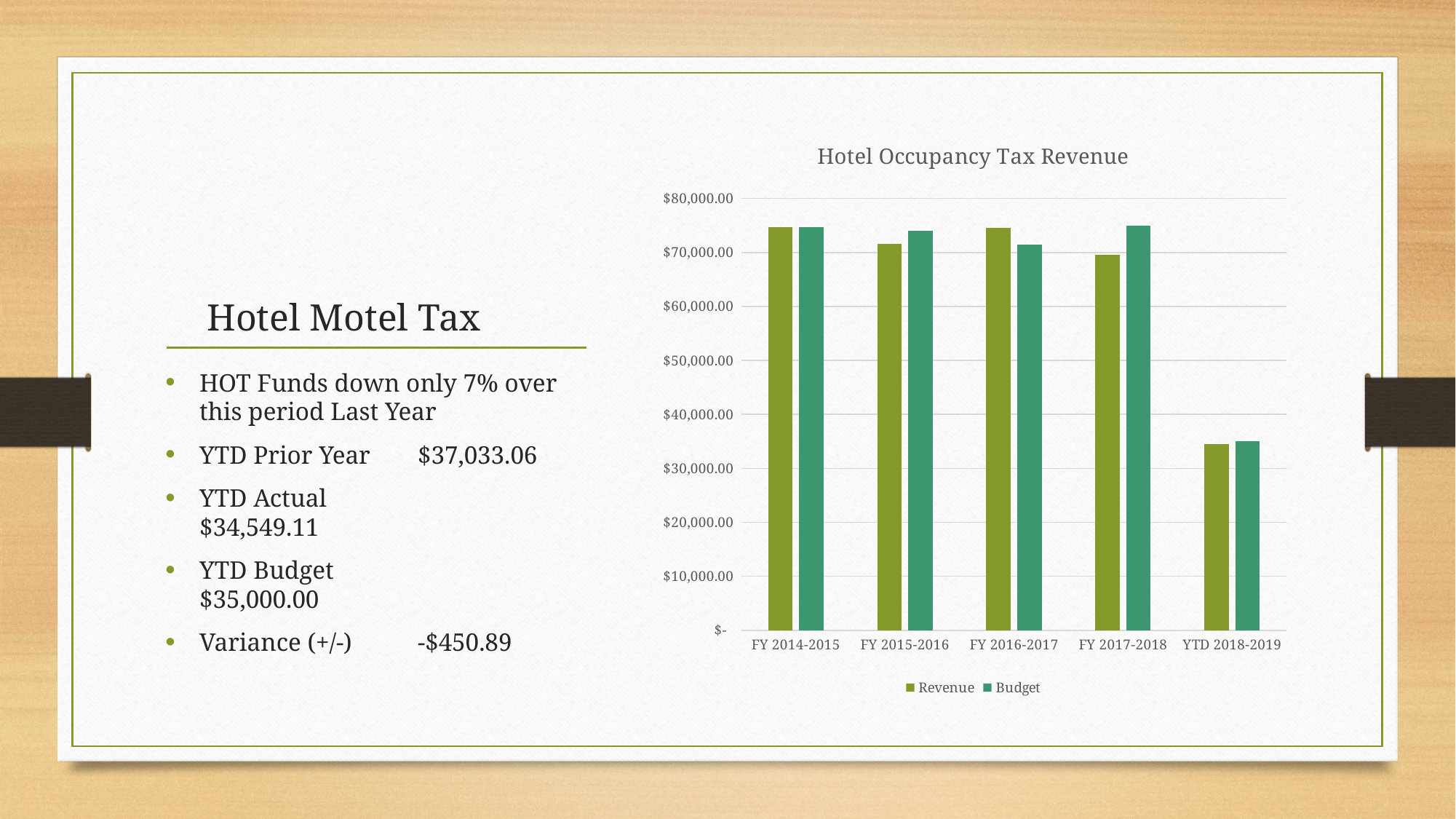
Is the Budget value for FY 2015-2016 greater or less than $70,000.00? greater Which series are listed in the chart legend? Revenue and Budget How many fiscal-year categories are shown on the x axis of the chart? 5 For FY 2016-2017, which is larger, Revenue or Budget? Revenue Which category has the lowest Revenue bar? YTD 2018-2019 Is the Revenue value for YTD 2018-2019 greater or less than $40,000.00? less For FY 2015-2016, which is larger, Revenue or Budget? Budget How many series does the chart legend list? 2 What is the title of the chart? Hotel Occupancy Tax Revenue What kind of chart is shown on the slide? Bar chart For FY 2017-2018, which is larger, Revenue or Budget? Budget Which category has the lowest Budget bar? YTD 2018-2019